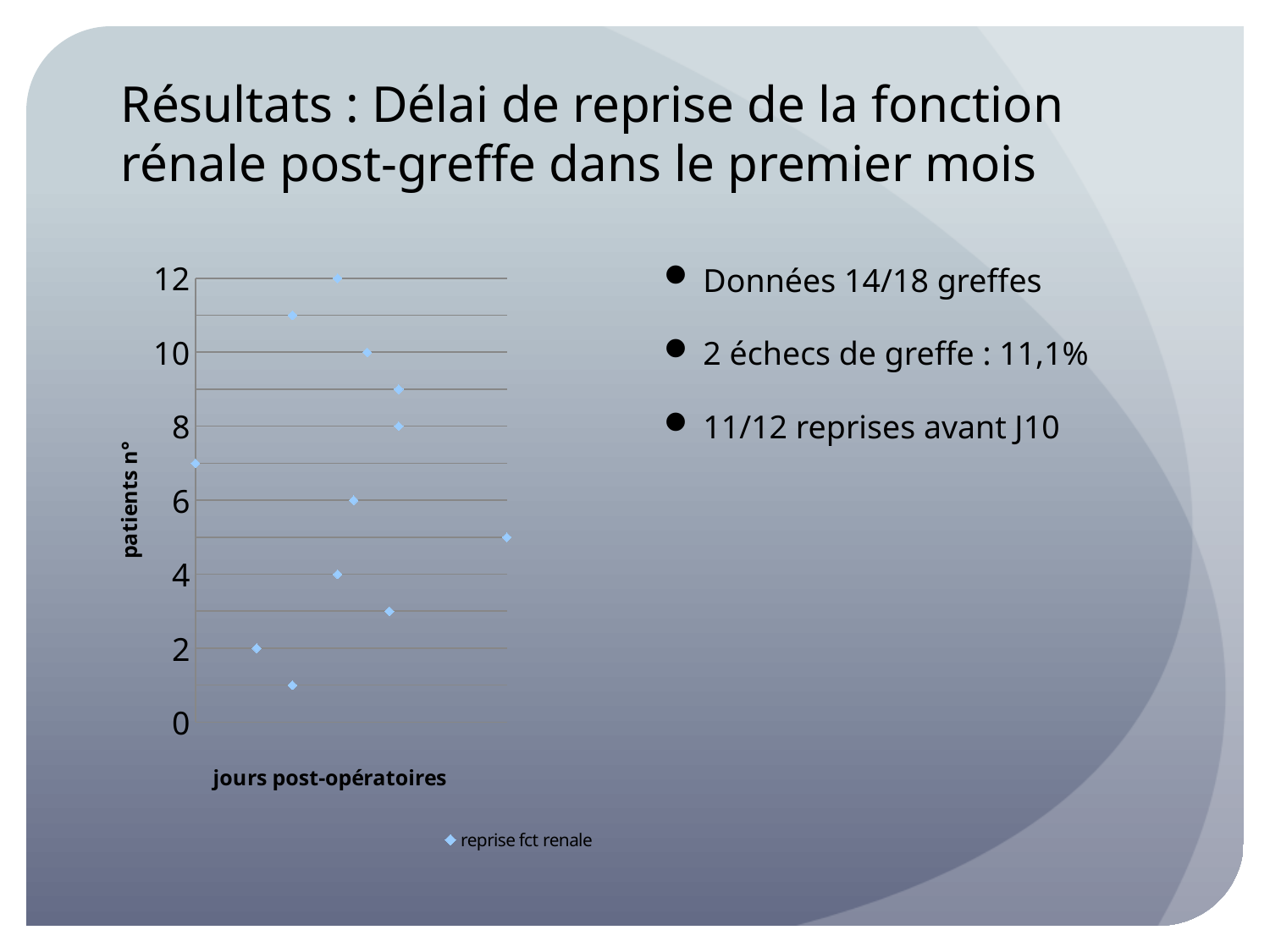
How many data points are plotted in the chart? 12 Which point lies further to the right along the x axis: the one for patient 1 or the one for patient 12? patient 12 What is the title of the vertical axis of the chart? patients n° How many series does the chart legend list? 1 What is the name of the series shown in the chart legend? reprise fct renale Which point lies further to the right along the x axis: the one for patient 2 or the one for patient 9? patient 9 Which patient number has the point farthest to the right on the chart (longest delay in days)? 5 What kind of chart is shown on the slide? scatter chart Which patient number has the point farthest to the left on the chart (shortest delay in days)? 7